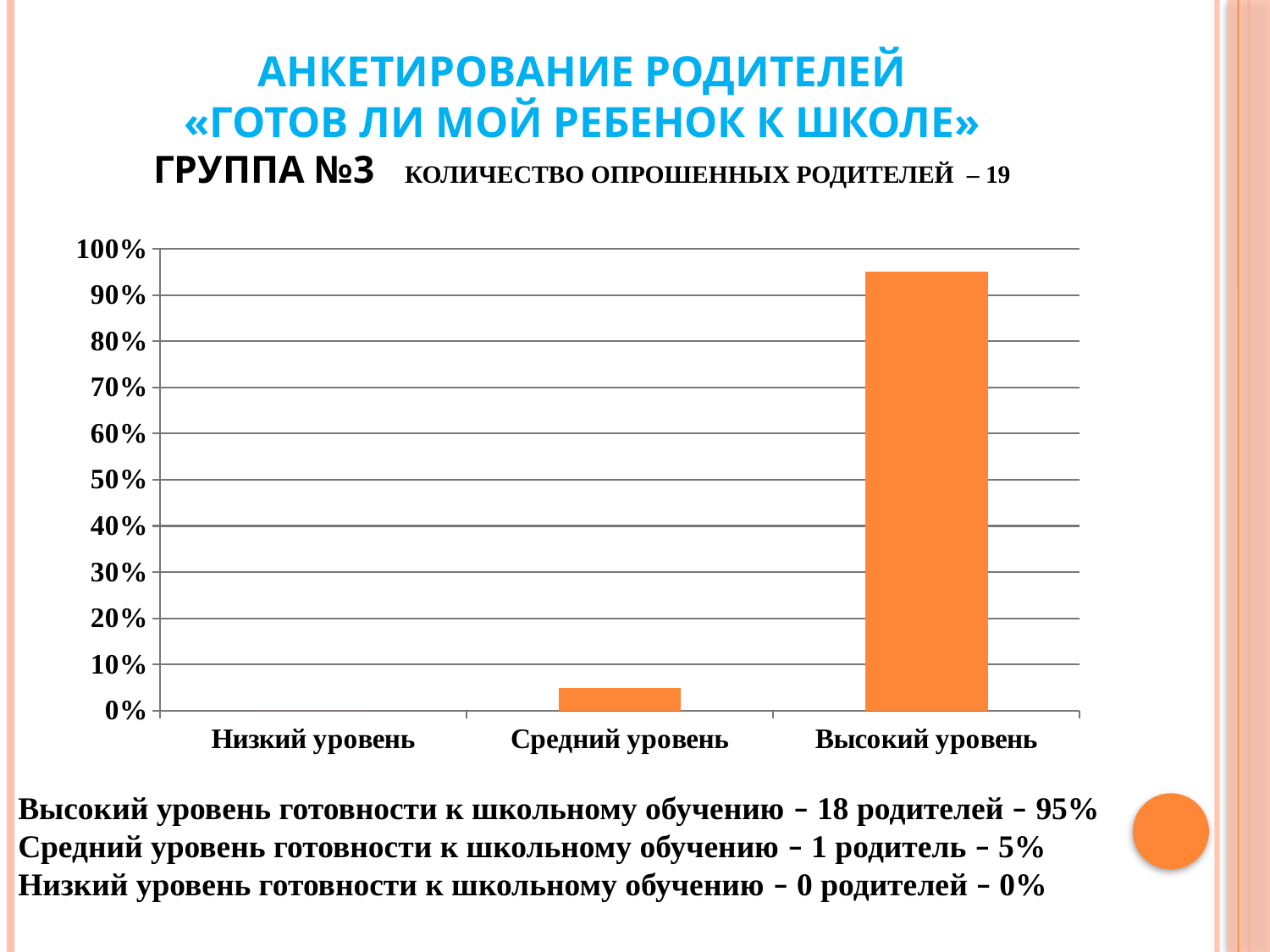
Is the value for Высокий уровень greater or less than 90%? greater Which category has the lowest value in the chart? Низкий уровень What kind of chart is shown on the slide? bar chart What is the difference between the values for Высокий уровень and Средний уровень? 90% What is the value for Средний уровень? 5% Which category has the highest bar in the chart? Высокий уровень Which is larger, the value for Средний уровень or the value for Высокий уровень? Высокий уровень What is the value for Высокий уровень? 95% How many categories are shown on the x axis of the chart? 3 What colour are the bars in the chart? orange What is the value for Низкий уровень? 0% Is the value for Средний уровень greater or less than 10%? less